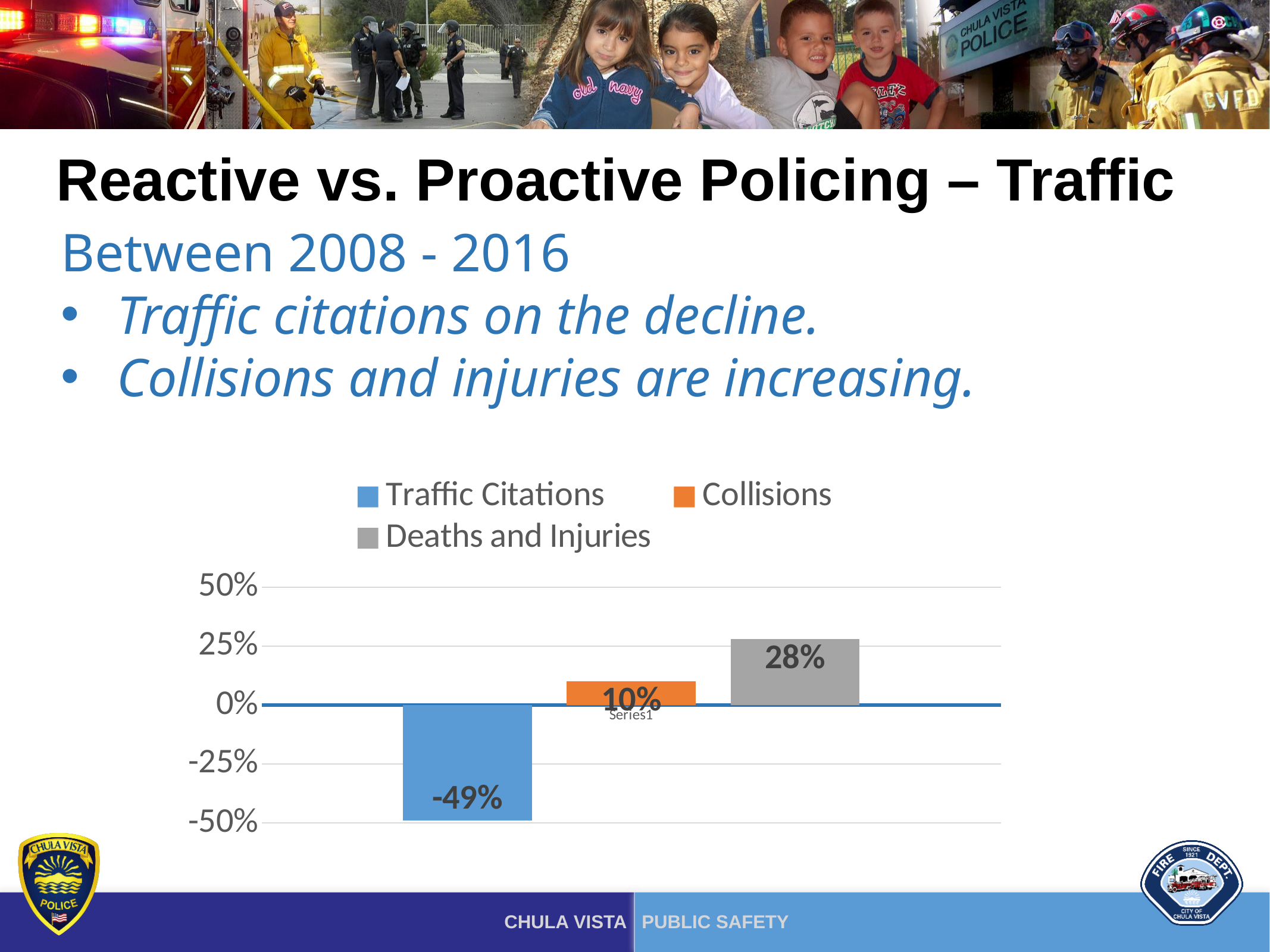
What kind of chart is shown on the slide? bar chart Is the value for Traffic Citations greater or less than -25%? less How many series does the legend list? 3 What is the value shown for Collisions? 10% What is the value shown for Traffic Citations? -49% What is the difference between the Deaths and Injuries value and the Collisions value? 18% What colour is the bar for Collisions? orange Which series has the highest value? Deaths and Injuries What is the value shown for Deaths and Injuries? 28% Which series has the lowest value? Traffic Citations Which is larger, the value for Collisions or the value for Deaths and Injuries? Deaths and Injuries Is the value for Deaths and Injuries greater or less than 25%? greater